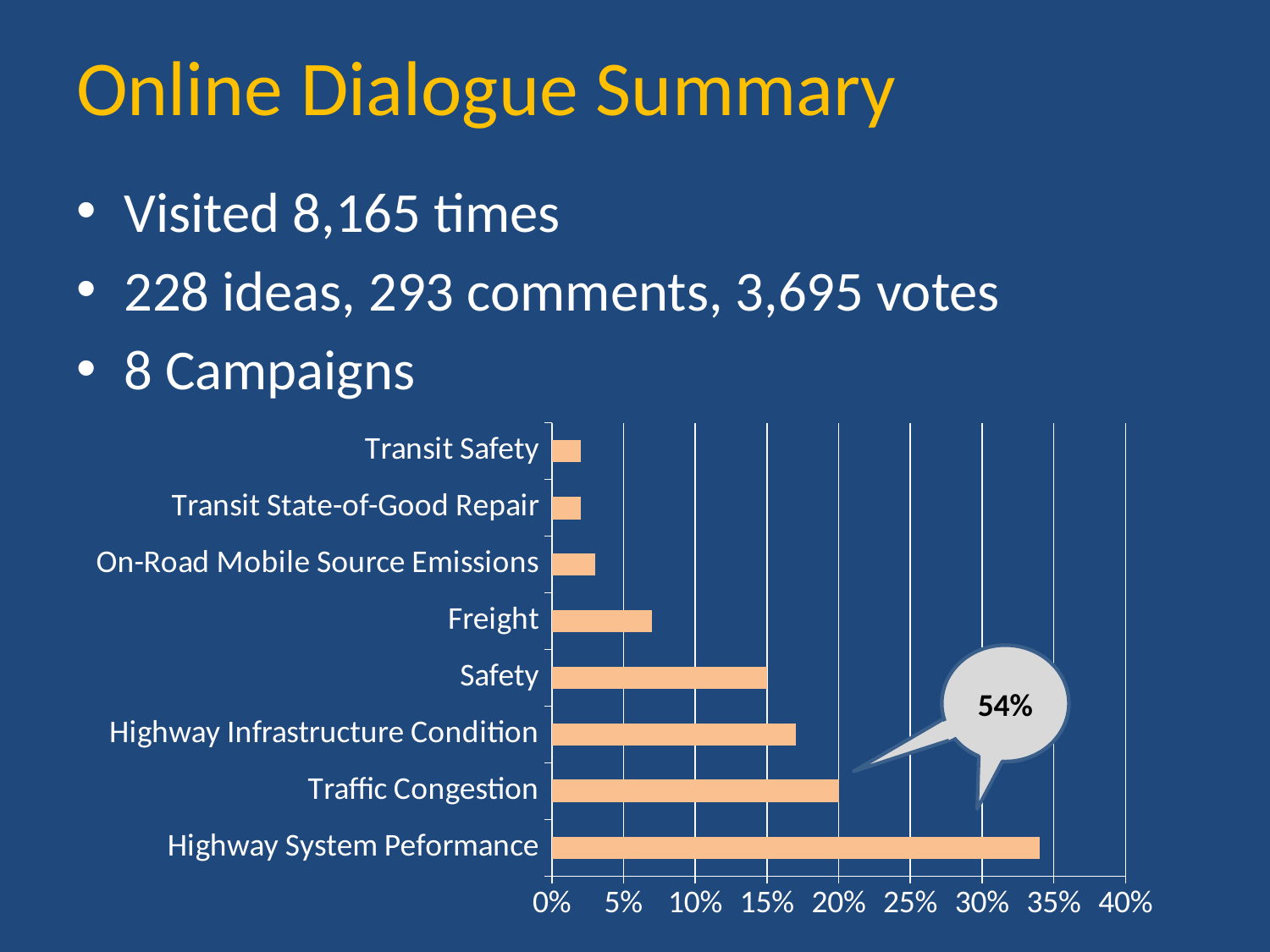
What percentage is shown in the callout bubble on the chart? 54% Which has a larger value, Traffic Congestion or Highway Infrastructure Condition? Traffic Congestion Is the value for Highway Infrastructure Condition greater or less than 20%? less Which has a larger value, Freight or Safety? Safety Is the value for Freight greater or less than 5%? greater Is the value for Highway Infrastructure Condition greater or less than 15%? greater What is the highest value shown on the x axis of the chart? 40% What kind of chart is shown on the slide? bar chart How many categories are plotted in the bar chart? 8 Which category has the highest value in the bar chart? Highway System Peformance